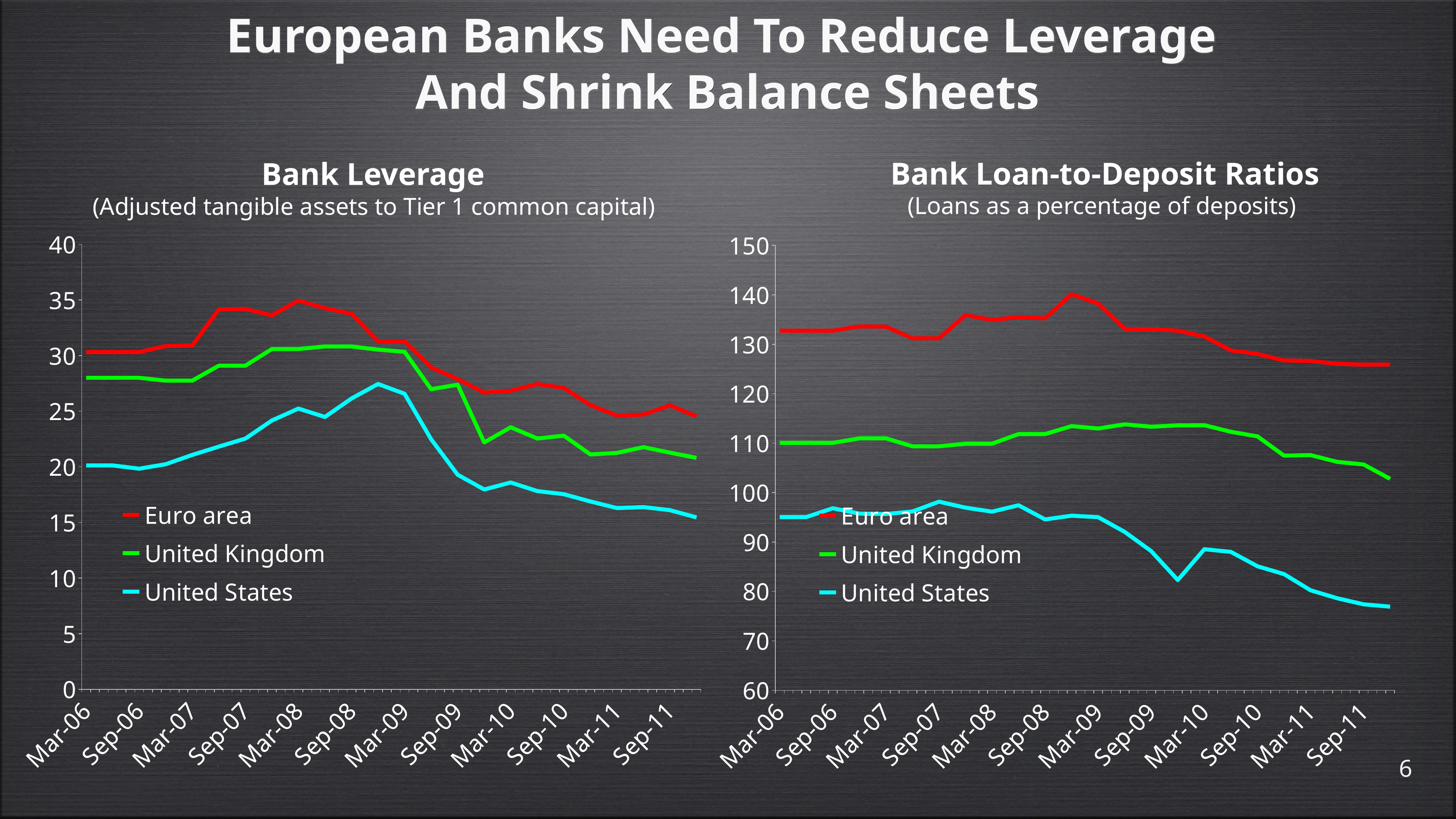
What is the subtitle shown under the Bank Loan-to-Deposit Ratios chart title? (Loans as a percentage of deposits) How many series does the legend of the Bank Loan-to-Deposit Ratios chart list? 3 In the Bank Leverage chart, is the value for United Kingdom at Mar-06 greater or less than 25? greater In the Bank Leverage chart, which is larger at Sep-11, Euro area or United States? Euro area In the Bank Loan-to-Deposit Ratios chart, which is larger at Mar-06, United Kingdom or United States? United Kingdom In the Bank Loan-to-Deposit Ratios chart, is the value for United States at Sep-11 greater or less than 80? less In the Bank Leverage chart, is the value for Euro area at Sep-07 greater or less than 30? greater In the Bank Leverage chart, which series is shown in green? United Kingdom What kind of chart is the Bank Leverage chart on the left? line chart In the Bank Leverage chart, does the United States series rise or fall from Mar-09 to Sep-11? fall